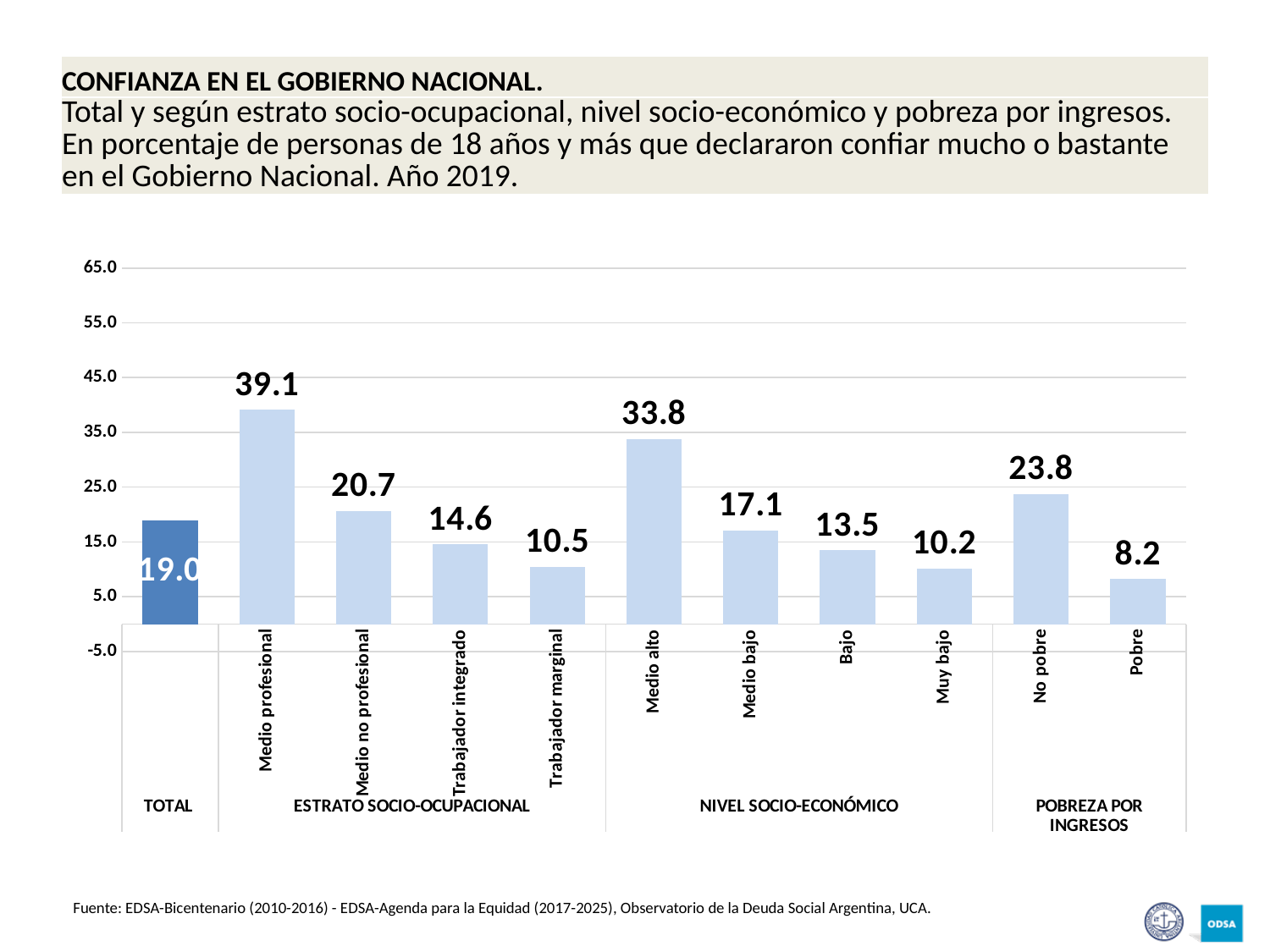
What is the value for Medio alto? 33.8 What is the value for Medio profesional? 39.1 Which is larger, the value for Medio bajo or the value for Bajo? Medio bajo What is the value for the TOTAL bar? 19.0 Which bar is shown in a darker blue than the others? TOTAL What is the value for Pobre? 8.2 What is the difference between the values for No pobre and Pobre? 15.6 Which category has the highest value? Medio profesional Which category has the lowest value? Pobre Is the value for Trabajador marginal greater or less than 15.0? less How many bars are plotted in the chart? 11 What kind of chart is shown on the slide? bar chart